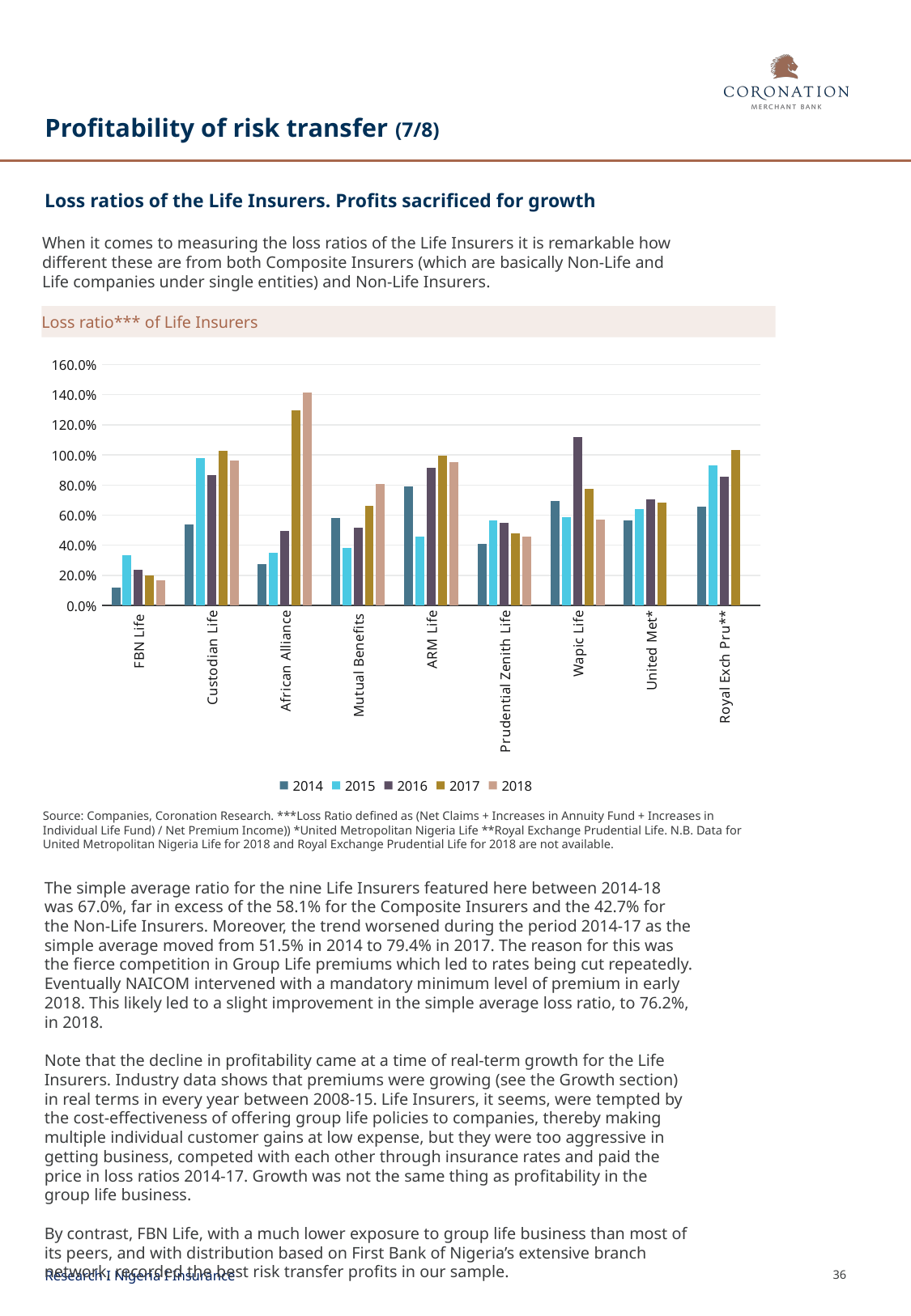
Which insurer has the lowest 2014 loss ratio in the chart? FBN Life How many series does the chart's legend list? 5 What is the title of the chart? Loss ratio*** of Life Insurers Is the 2014 loss ratio for FBN Life greater or less than 20.0%? less Is the 2018 loss ratio for African Alliance greater or less than 120.0%? greater Which is larger for FBN Life: the 2014 loss ratio or the 2015 loss ratio? 2015 Do the loss ratios for African Alliance rise or fall from 2014 to 2018? rise What kind of chart is shown on the slide? bar chart Which is larger for Wapic Life: the 2016 loss ratio or the 2017 loss ratio? 2016 How many life insurers (categories) are shown on the x axis of the chart? 9 Is the 2016 loss ratio for Wapic Life greater or less than 100.0%? greater Which insurer has the tallest bar in the chart? African Alliance